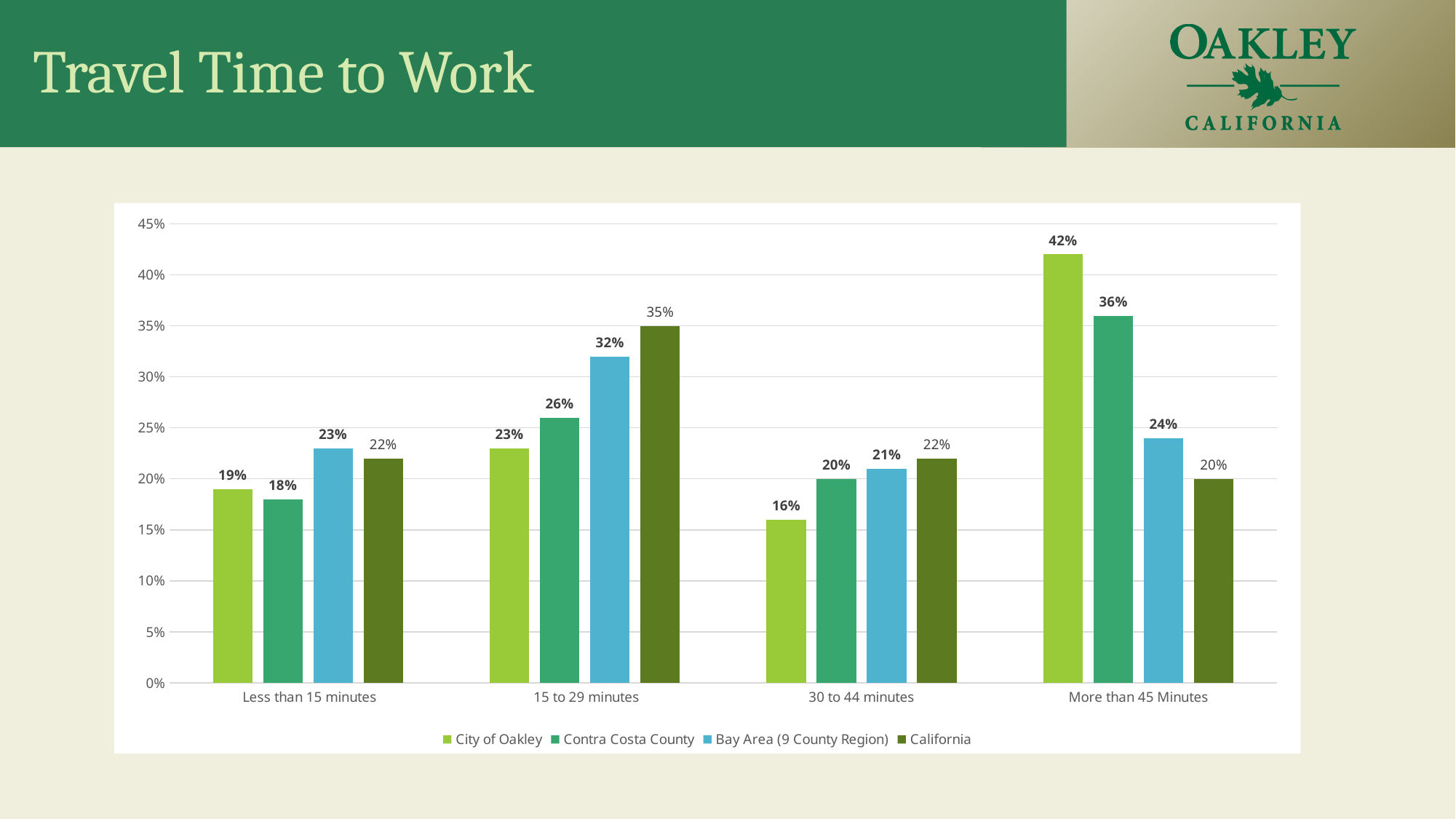
What is the difference between the City of Oakley and California values in the 'More than 45 Minutes' category? 22% How many series does the legend list? 4 What is the value for Bay Area (9 County Region) in the 'Less than 15 minutes' category? 23% How many travel time categories are shown on the x axis? 4 Which travel time category has the lowest value for City of Oakley? 30 to 44 minutes In the '15 to 29 minutes' category, which is larger: the value for City of Oakley or the value for Bay Area (9 County Region)? Bay Area (9 County Region) Which series is shown in blue in the legend? Bay Area (9 County Region) What is the value for City of Oakley in the 'More than 45 Minutes' category? 42% Which travel time category has the highest value for City of Oakley? More than 45 Minutes What is the value for California in the '15 to 29 minutes' category? 35% What is the value for Contra Costa County in the '30 to 44 minutes' category? 20% What kind of chart is shown on the slide? Bar chart